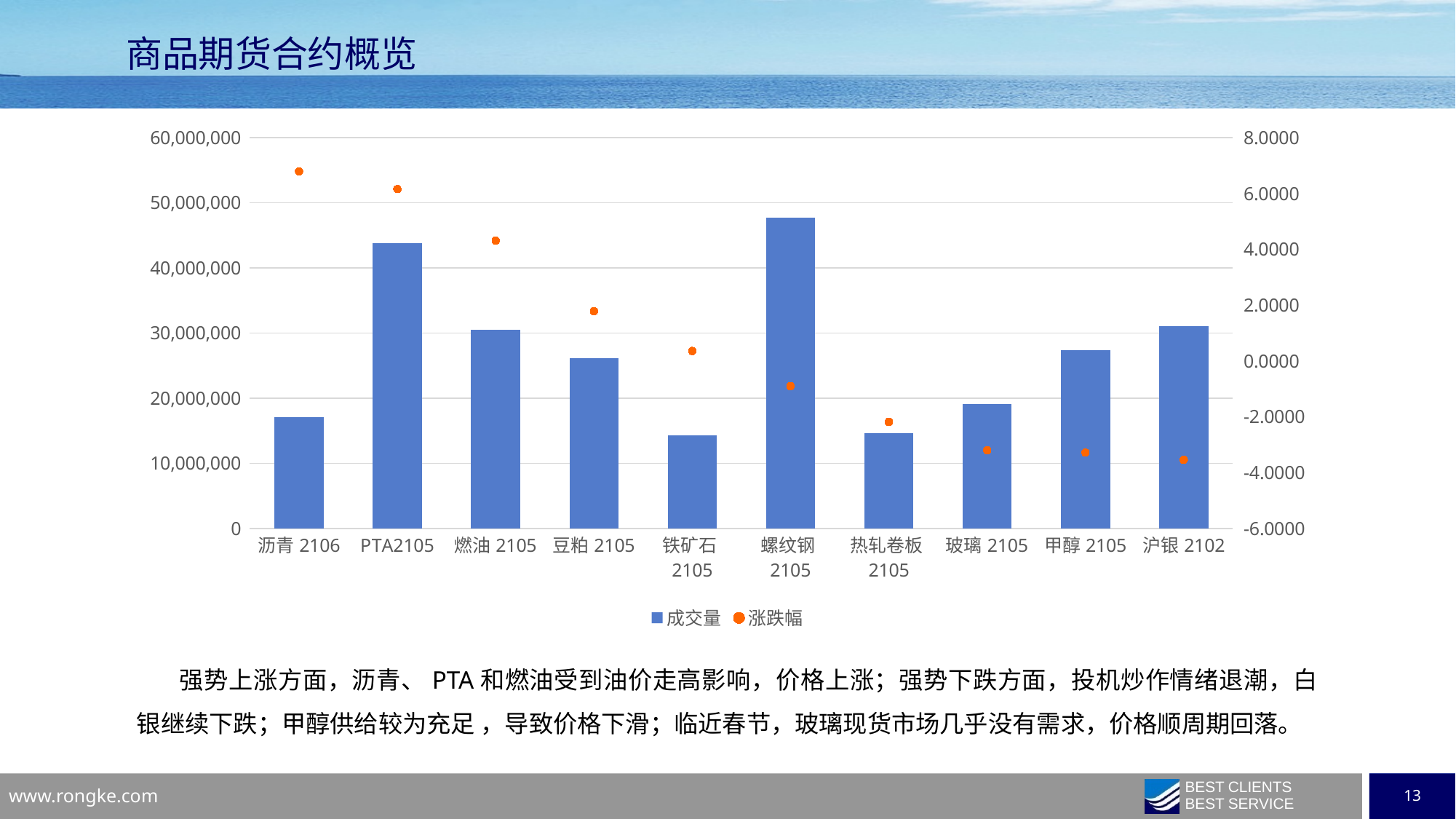
What kind of chart is shown on the slide? bar chart with a dot series on a secondary axis Is the 成交量 value for 螺纹钢 2105 greater or less than 40,000,000? greater What are the two series named in the chart legend? 成交量 and 涨跌幅 Which category has the highest 涨跌幅 dot? 沥青 2106 Is the 涨跌幅 value for 沥青 2106 greater or less than 6.0000? greater Is the 成交量 value for 沥青 2106 greater or less than 20,000,000? less Do the 涨跌幅 dots generally rise or fall from left to right along the x axis? fall Which has the larger 成交量 bar, PTA2105 or 燃油 2105? PTA2105 How many series does the chart legend list? 2 Which category has the highest 成交量 bar? 螺纹钢 2105 How many categories are shown on the x axis of the chart? 10